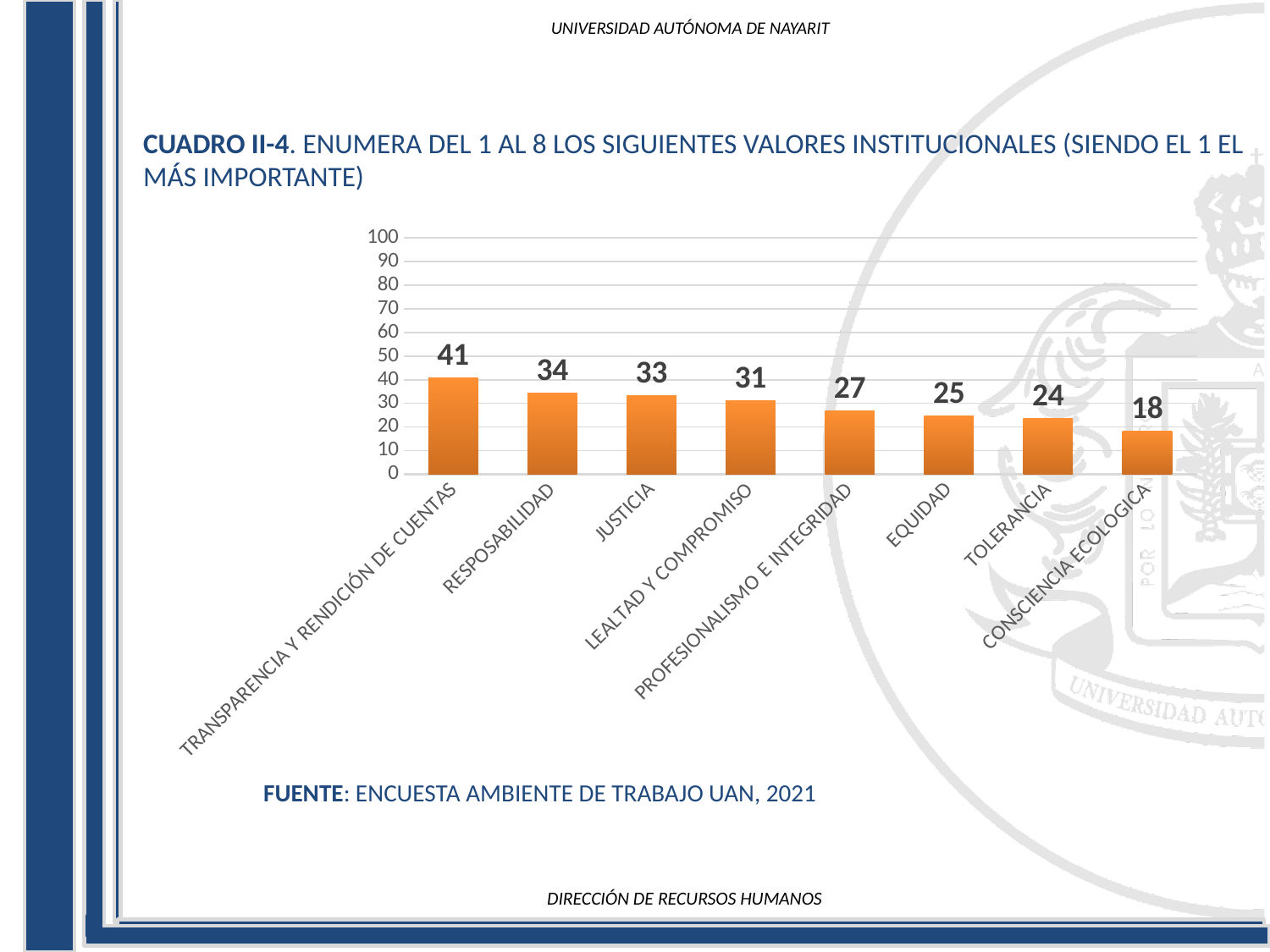
Is the value for RESPOSABILIDAD greater or less than 30? greater Which category has the lowest value? CONSCIENCIA ECOLOGICA How many categories are shown in the chart? 8 Which is larger, the value for LEALTAD Y COMPROMISO or the value for PROFESIONALISMO E INTEGRIDAD? LEALTAD Y COMPROMISO What is the value for JUSTICIA? 33 What is the value for CONSCIENCIA ECOLOGICA? 18 Do the values rise or fall from left to right along the x axis? fall What is the difference between the values for RESPOSABILIDAD and TOLERANCIA? 10 What is the value for TRANSPARENCIA Y RENDICIÓN DE CUENTAS? 41 Which category has the highest value? TRANSPARENCIA Y RENDICIÓN DE CUENTAS What is the value for EQUIDAD? 25 What kind of chart is shown on the slide? bar chart